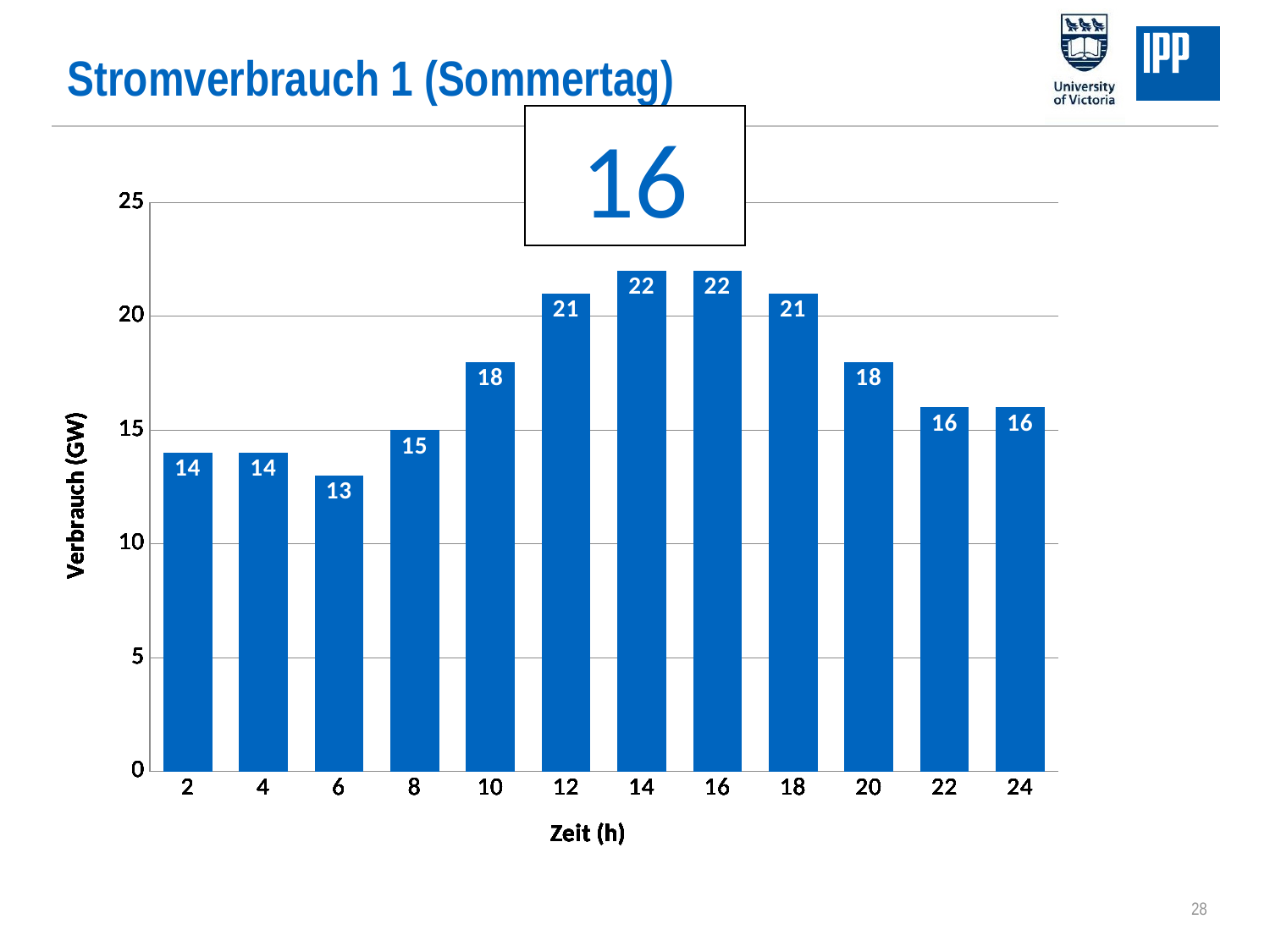
What is the Verbrauch (GW) value at Zeit 6 h? 13 Does the Verbrauch (GW) rise or fall from Zeit 16 h to Zeit 24 h? fall Is the Verbrauch (GW) value at Zeit 18 h greater or less than 20? greater Which hour has the lowest Verbrauch (GW)? 6 What kind of chart is shown on the slide? bar chart Which has a larger Verbrauch (GW): Zeit 10 h or Zeit 8 h? 10 h What is the label of the x axis? Zeit (h) How many bars are shown in the chart? 12 What is the Verbrauch (GW) value at Zeit 22 h? 16 What is the difference in Verbrauch (GW) between Zeit 14 h and Zeit 6 h? 9 What is the Verbrauch (GW) value at Zeit 12 h? 21 What is the highest Verbrauch (GW) value shown in the chart? 22